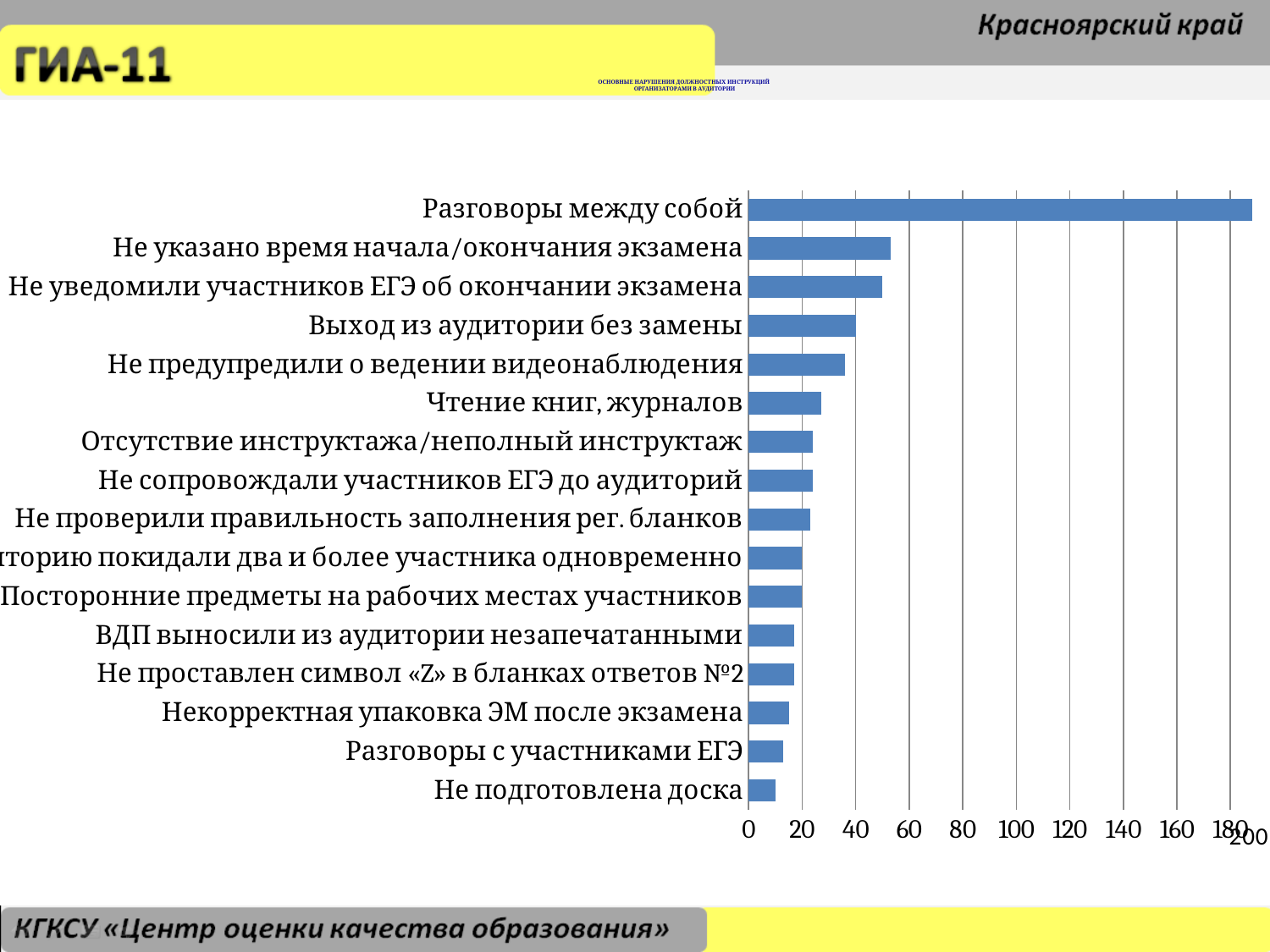
Is the value for Разговоры с участниками ЕГЭ greater or less than 20? less Is the value for Не указано время начала/окончания экзамена greater or less than 40? greater What kind of chart is shown on the slide? bar chart Which is larger: the value for Разговоры между собой or the value for Не указано время начала/окончания экзамена? Разговоры между собой Is the value for Чтение книг, журналов greater or less than 20? greater Which category has the highest value in the chart? Разговоры между собой How many categories (violation types) are plotted in the chart? 16 Which is larger: the value for Не уведомили участников ЕГЭ об окончании экзамена or the value for Выход из аудитории без замены? Не уведомили участников ЕГЭ об окончании экзамена Which category has the lowest value in the chart? Не подготовлена доска What colour are the bars in the chart? blue